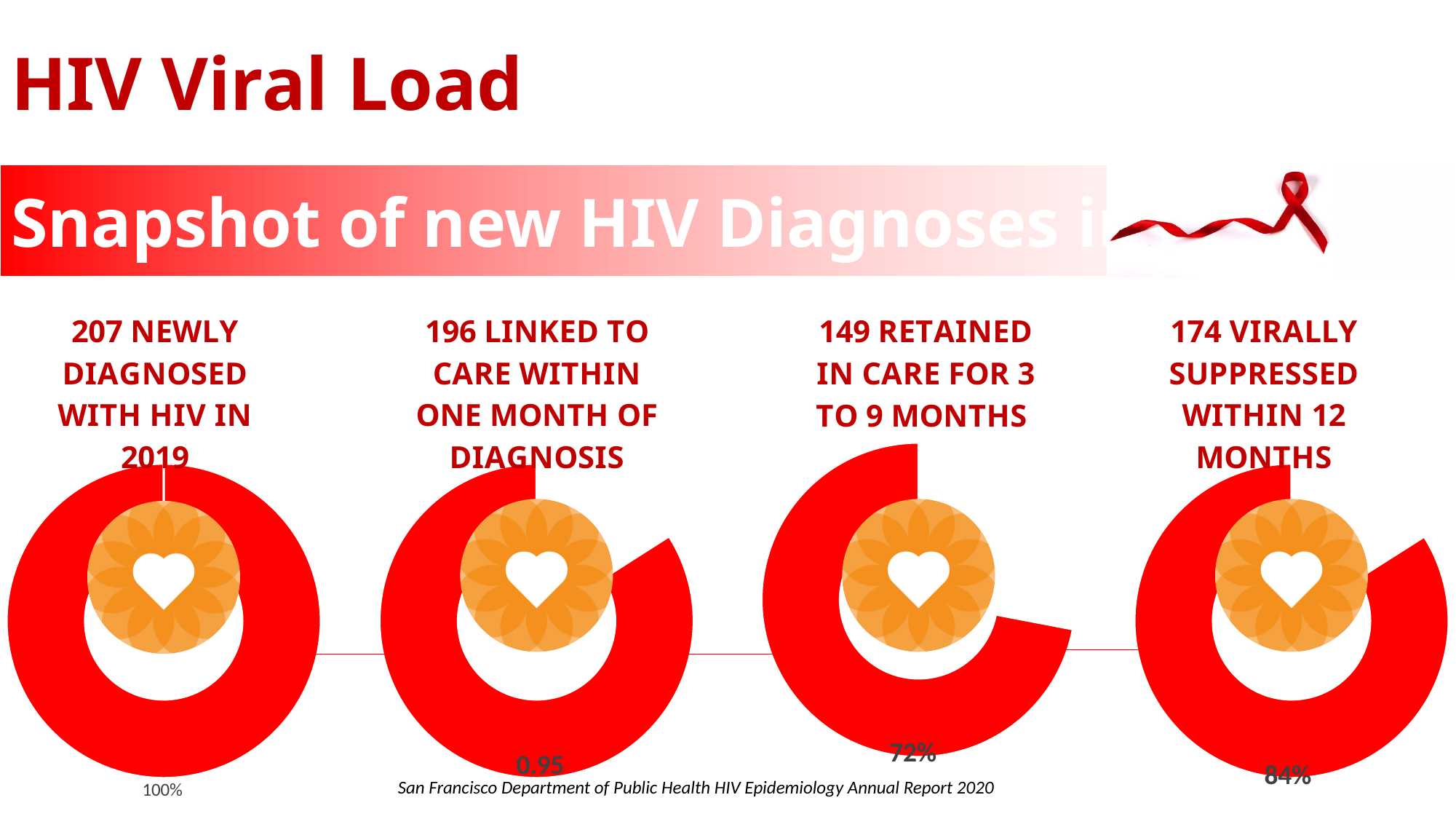
What value is printed below the second doughnut chart (196 linked to care within one month of diagnosis)? 0.95 How many people does the heading above the third doughnut chart say were retained in care for 3 to 9 months? 149 What value is printed below the first doughnut chart (207 newly diagnosed with HIV in 2019)? 100% What value is printed below the third doughnut chart (149 retained in care for 3 to 9 months)? 72% Which of the four doughnut charts shows the lowest percentage? 149 retained in care for 3 to 9 months (72%) Which of the four doughnut charts shows the highest percentage? 207 newly diagnosed with HIV in 2019 (100%) What is the difference in percentage points between the virally suppressed chart (84%) and the retained in care chart (72%)? 12 percentage points Which is larger: the percentage for the virally suppressed chart or the percentage for the retained in care chart? Virally suppressed (84%) How many doughnut charts are shown on the slide? 4 What value is printed below the fourth doughnut chart (174 virally suppressed within 12 months)? 84% What source is cited at the bottom of the slide? San Francisco Department of Public Health HIV Epidemiology Annual Report 2020 What kind of chart is used for each of the four figures on the slide? Doughnut chart